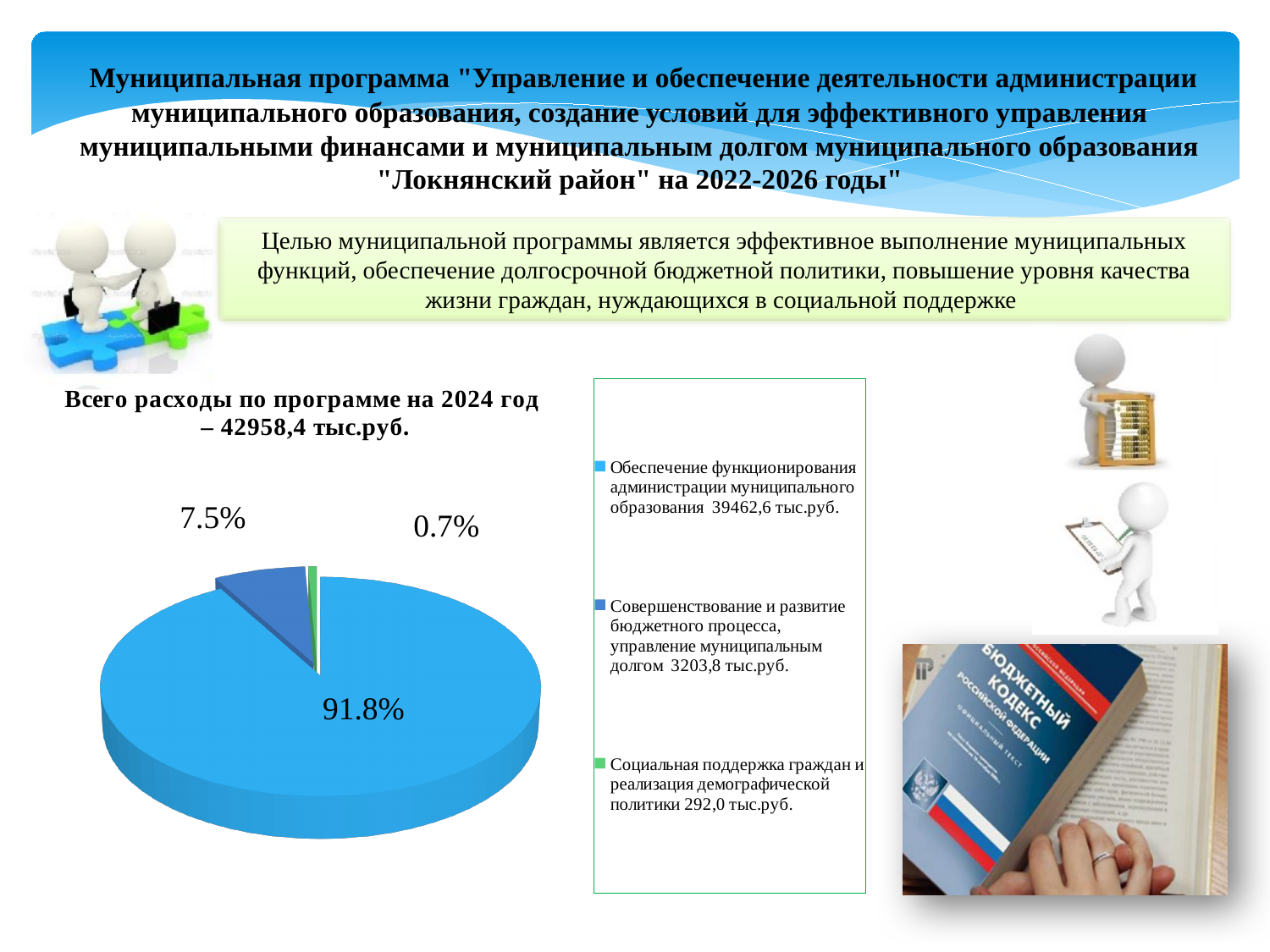
What share of the pie does the slice for "Социальная поддержка граждан и реализация демографической политики" represent? 0.7% According to the legend, what amount in тыс.руб. corresponds to "Совершенствование и развитие бюджетного процесса, управление муниципальным долгом"? 3203,8 тыс.руб. Which category has the smallest slice in the pie chart? Социальная поддержка граждан и реализация демографической политики How many entries does the legend of the pie chart list? 3 What total programme expenditure for 2024 is stated in the chart's title? 42958,4 тыс.руб. What kind of chart is shown on the slide? pie chart What share of the pie does the slice for "Совершенствование и развитие бюджетного процесса, управление муниципальным долгом" represent? 7.5% What share of the pie does the slice for "Обеспечение функционирования администрации муниципального образования" represent? 91.8% What is the difference in percentage points between the 91.8% slice and the 7.5% slice? 84.3 Which category has the largest slice in the pie chart? Обеспечение функционирования администрации муниципального образования How many slices does the pie chart have? 3 Which is larger: the slice for "Совершенствование и развитие бюджетного процесса" or the slice for "Социальная поддержка граждан"? Совершенствование и развитие бюджетного процесса